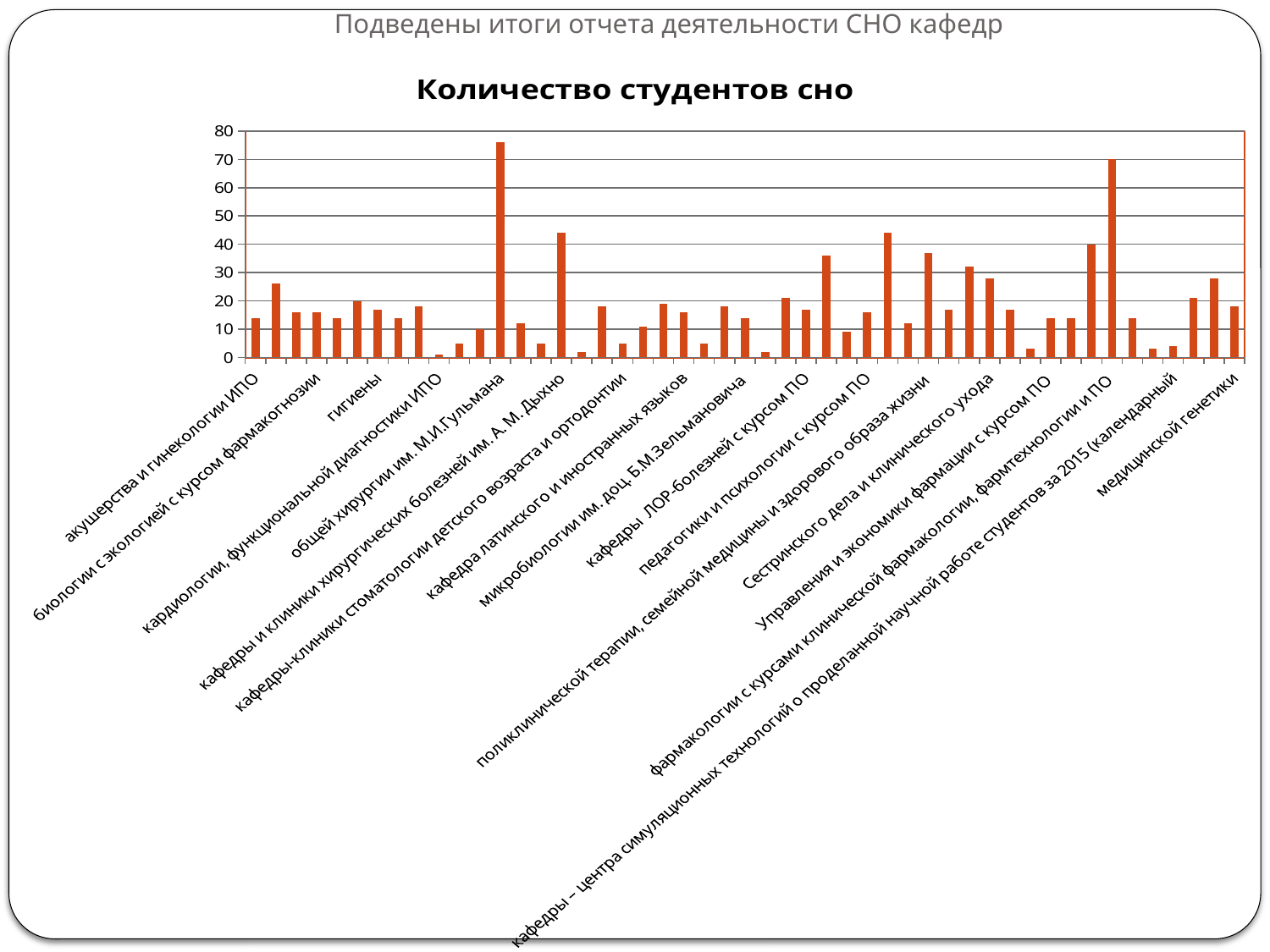
What colour are the bars in the chart? orange Which is larger: the value for общей хирургии им. М.И.Гульмана or the value for медицинской генетики? общей хирургии им. М.И.Гульмана Is the value for кафедры – центра симуляционных технологий greater or less than 10? less Is the value for фармакологии с курсами клинической фармакологии, фармтехнологии и ПО greater or less than 60? greater Is the value for медицинской генетики greater or less than 30? less Which category has the highest value in the chart? общей хирургии им. М.И.Гульмана Which is larger: the value for поликлинической терапии, семейной медицины и здорового образа жизни or the value for Сестринского дела и клинического ухода? поликлинической терапии, семейной медицины и здорового образа жизни What is the title of the chart? Количество студентов сно What kind of chart is shown on the slide? bar chart